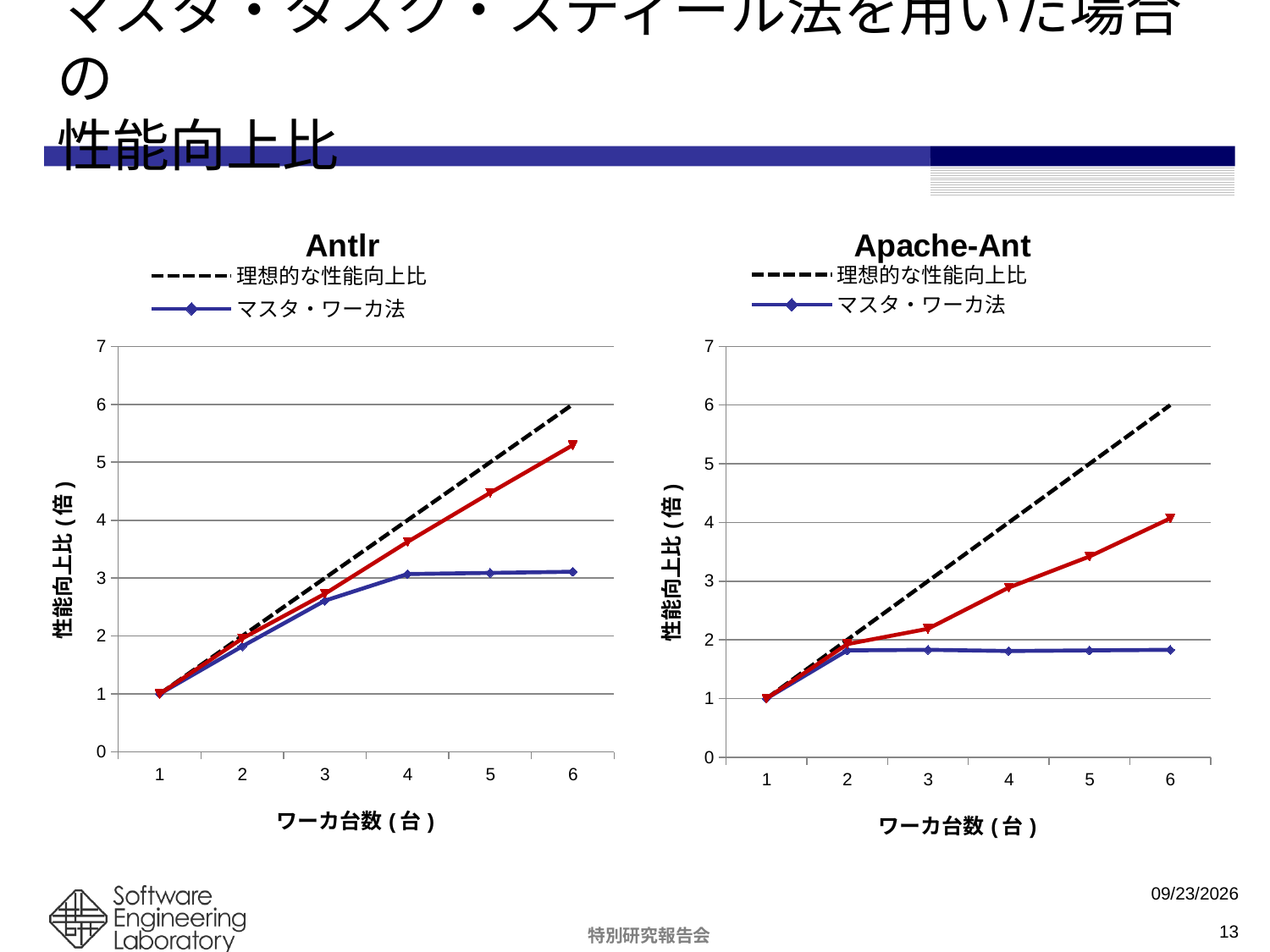
On the Antlr chart, is the value for マスタ・ワーカ法 at 6 workers greater or less than 4? less On the Antlr chart, at 6 workers, which is larger: the red line or マスタ・ワーカ法? the red line On the Antlr chart, what is the value of 理想的な性能向上比 at 6 workers? 6 On the Apache-Ant chart, is the value of the red line at 6 workers greater or less than 3? greater On the Apache-Ant chart, is the value for マスタ・ワーカ法 at 6 workers greater or less than 2? less How many worker counts (x-axis points) are plotted on the Antlr chart? 6 How many series does the legend of the Apache-Ant chart list? 2 On the Apache-Ant chart, what is the value of 理想的な性能向上比 at 1 worker? 1 What is the y-axis label of the Antlr chart? 性能向上比 (倍) What kind of chart is the Antlr chart? line chart On the Apache-Ant chart, does the red line rise or fall as the number of workers increases? rise